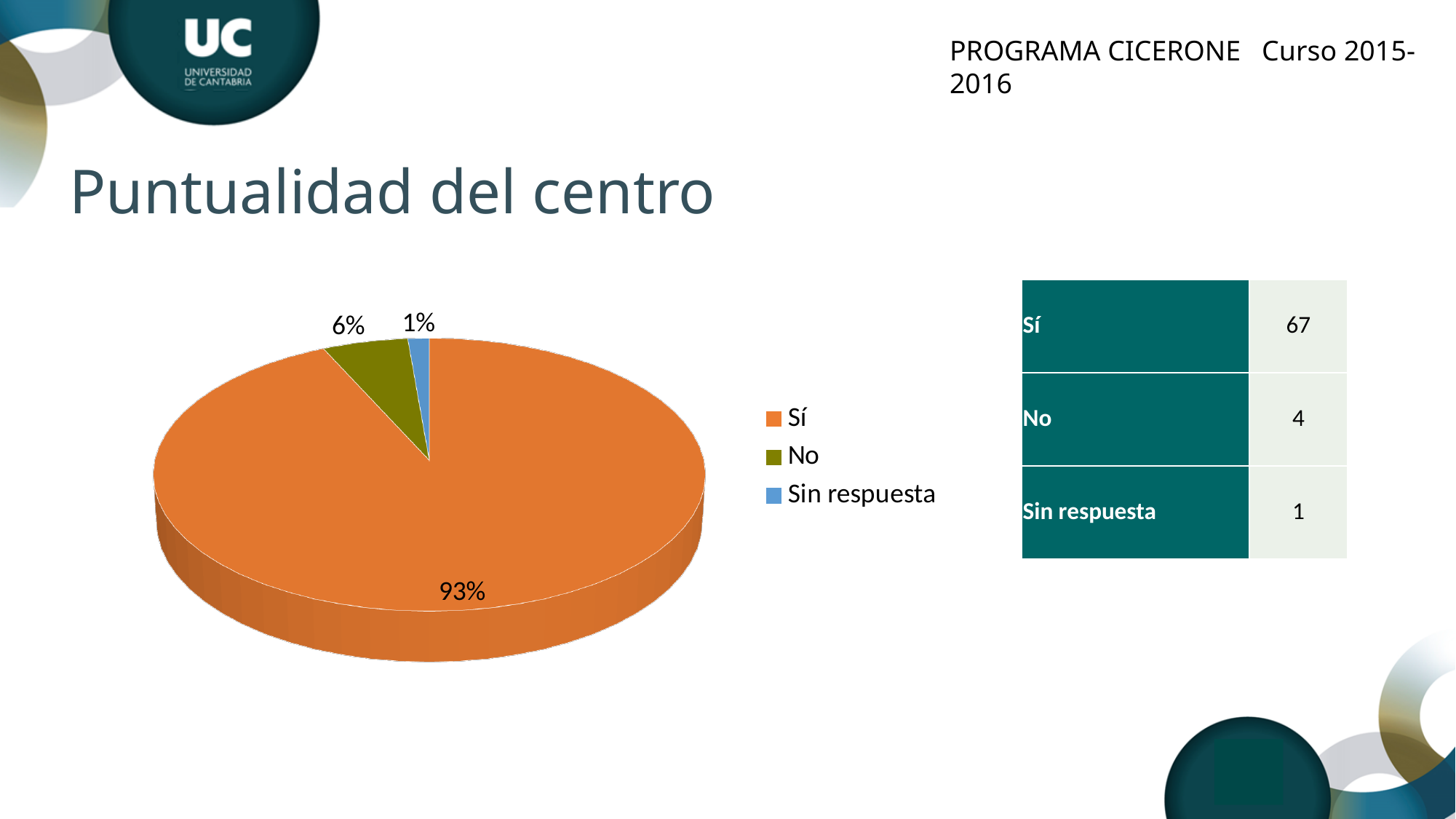
What percentage of the pie does the "No" slice represent? 6% Which category has the largest slice of the pie? Sí What is the difference in percentage points between the "Sí" slice and the "No" slice? 87 Which slice is larger, "No" or "Sin respuesta"? No How many slices does the pie chart have? 3 What percentage of the pie does the "Sí" slice represent? 93% Which category has the smallest slice of the pie? Sin respuesta What percentage of the pie does the "Sin respuesta" slice represent? 1% What type of chart is shown on the slide? pie chart How many entries does the legend list? 3 What colour is the "Sí" slice in the pie chart? orange What is the title of the chart on the slide? Puntualidad del centro